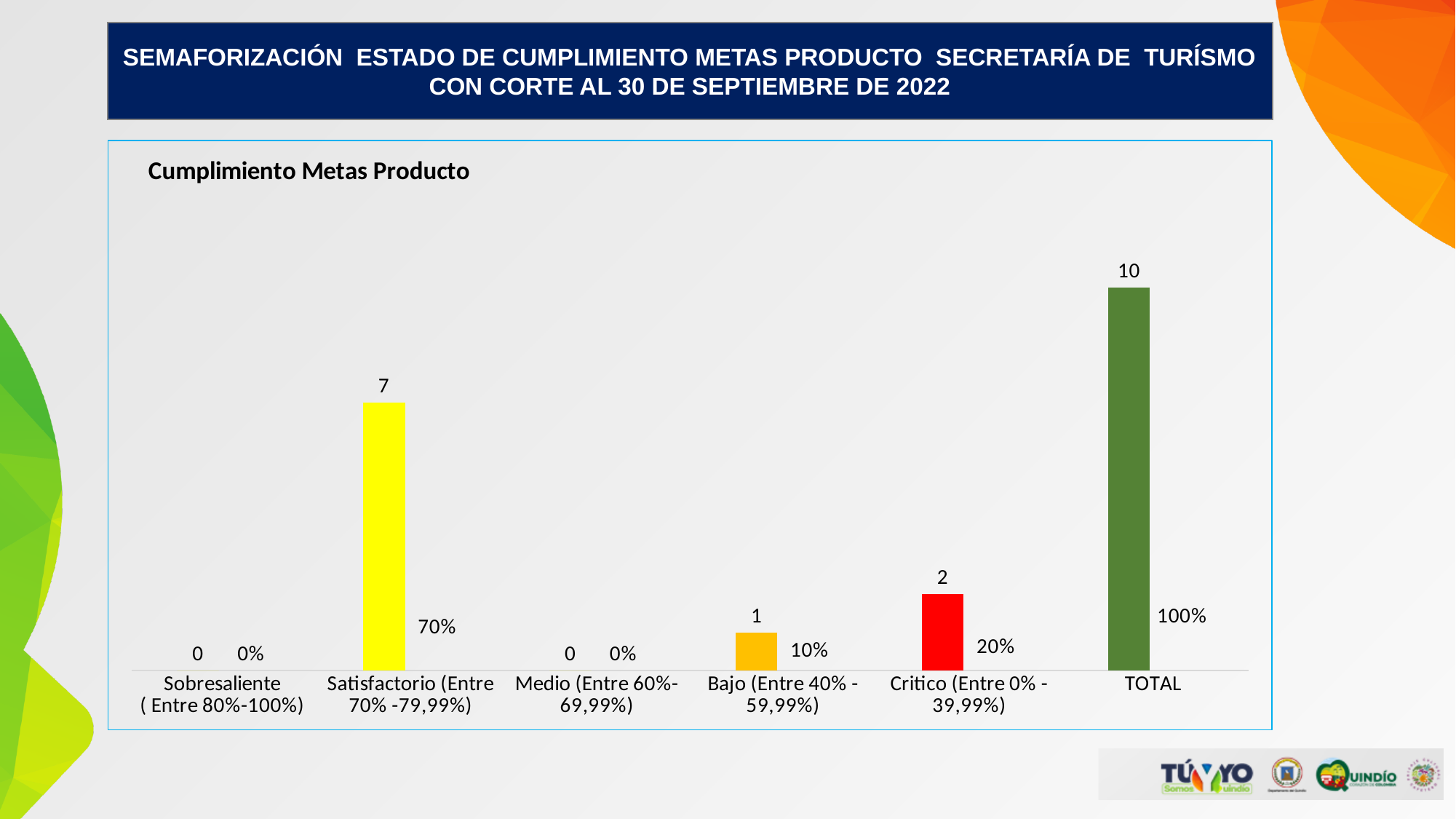
What kind of chart is shown on the slide? Bar chart What colour is the bar for the Critico (Entre 0% - 39,99%) category? Red What is the count value for the Satisfactorio (Entre 70% -79,99%) category? 7 What percentage is shown for the Critico (Entre 0% - 39,99%) category? 20% Which has a larger count, Bajo (Entre 40% - 59,99%) or Critico (Entre 0% - 39,99%)? Critico (Entre 0% - 39,99%) What is the difference between the count for Satisfactorio (Entre 70% -79,99%) and the count for Critico (Entre 0% - 39,99%)? 5 What is the title of the chart? Cumplimiento Metas Producto What is the value shown for the TOTAL category? 10 What is the count value for the Bajo (Entre 40% - 59,99%) category? 1 How many categories are shown on the x axis of the chart? 6 What percentage is shown for the Medio (Entre 60%-69,99%) category? 0% Excluding TOTAL, which category has the highest count? Satisfactorio (Entre 70% -79,99%)